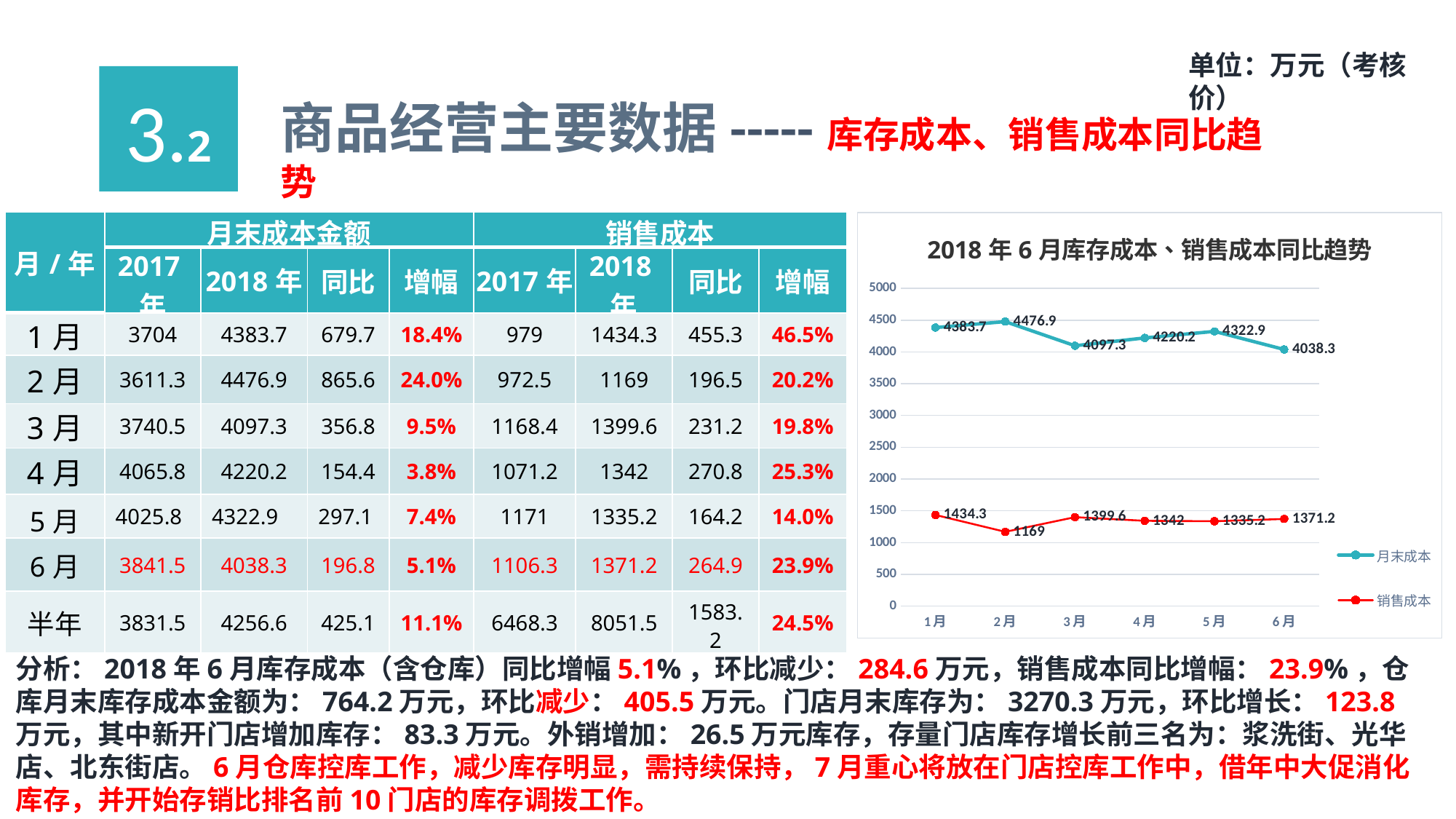
What is the value of 月末成本 for 6月 in the chart? 4038.3 Which is larger, 销售成本 in 1月 or 销售成本 in 2月? 1月 What is the value of 月末成本 for 2月 in the chart? 4476.9 In which month is 月末成本 highest in the chart? 2月 In which month is 销售成本 lowest in the chart? 2月 What is the difference between 月末成本 in 2月 and 3月? 379.6 Is the value of 月末成本 for 5月 greater or less than 4000? greater How many months are plotted on the x axis of the chart? 6 What is the value of 销售成本 for 3月 in the chart? 1399.6 What type of chart is shown on the slide? line chart What is the title of the chart? 2018年6月库存成本、销售成本同比趋势 How many series does the chart legend list? 2